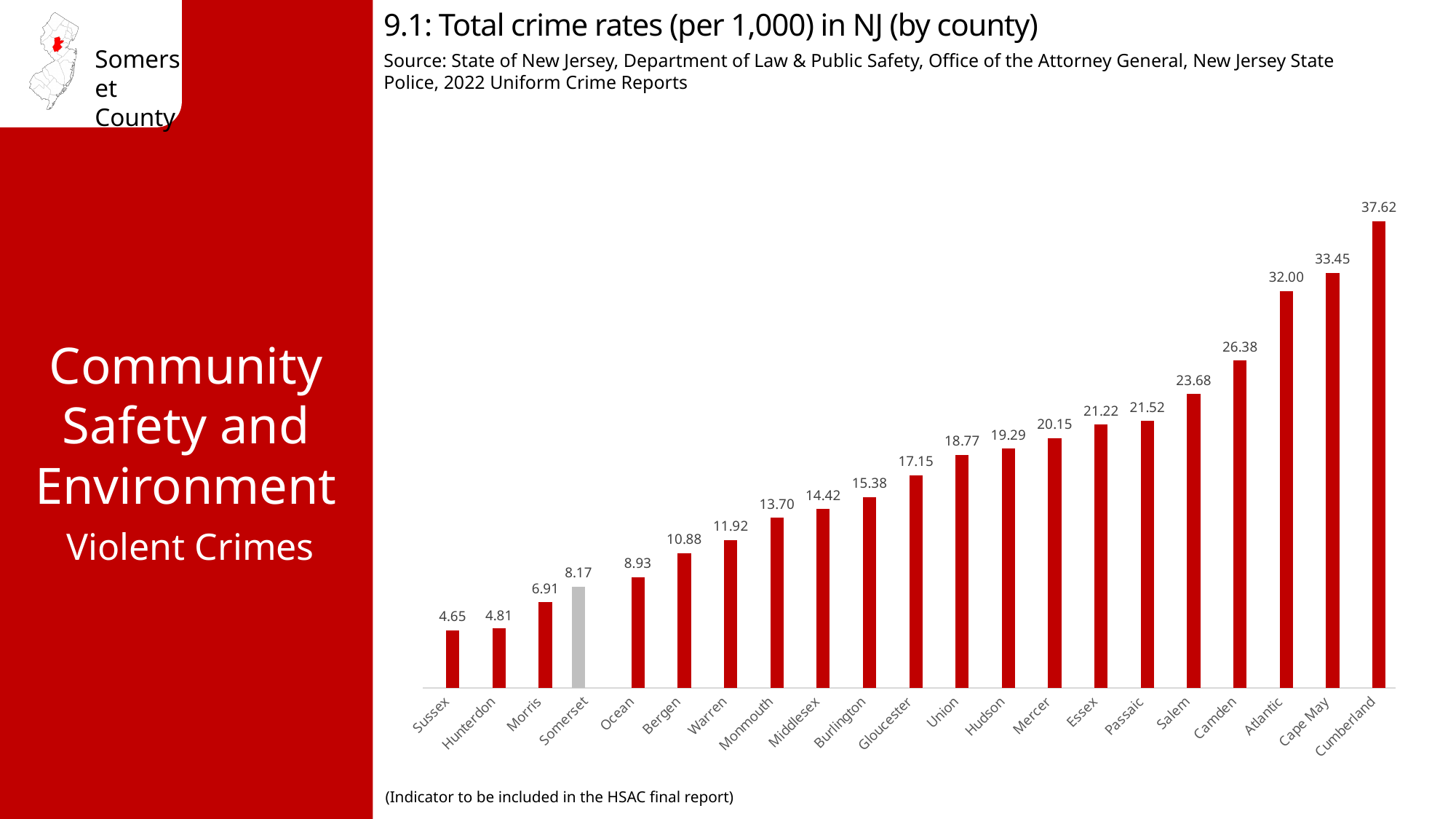
Which county has the highest total crime rate? Cumberland Which county has the lowest total crime rate? Sussex What is the total crime rate (per 1,000) for Hudson County? 19.29 What is the total crime rate (per 1,000) for Cumberland County? 37.62 Which county's bar is coloured grey instead of red? Somerset What type of chart is used to show total crime rates by county? Bar chart What is the difference between the total crime rates of Cumberland and Somerset? 29.45 How many counties are shown in the chart? 21 Which county has a higher total crime rate, Camden or Salem? Camden Do the total crime rates rise or fall moving from left to right along the x axis? Rise What is the total crime rate (per 1,000) for Somerset County? 8.17 What is the difference between the total crime rates of Cape May and Atlantic? 1.45